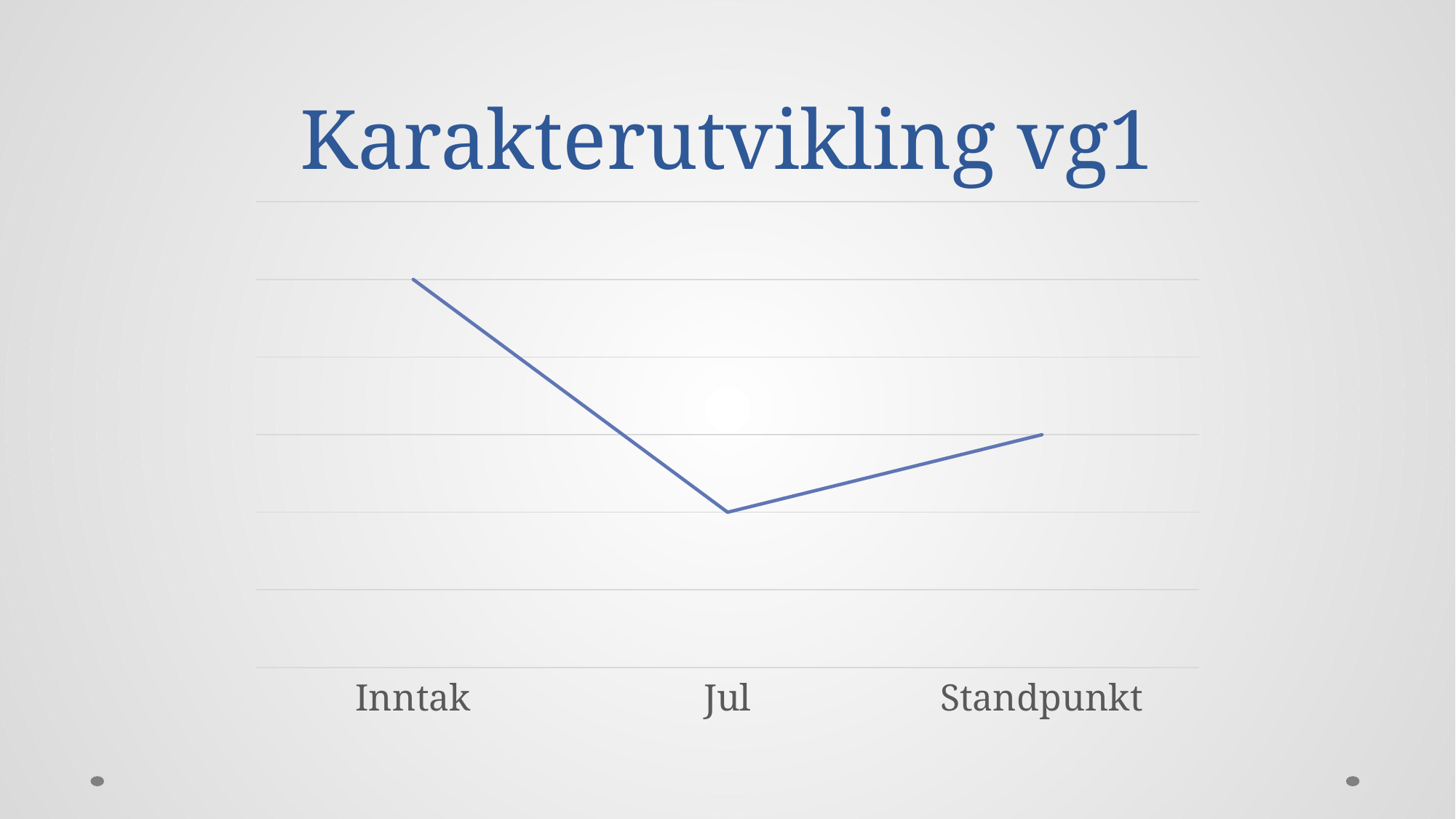
Which category has the lowest value? Jul Which is higher, the value for Jul or the value for Standpunkt? Standpunkt What is the title of the chart? Karakterutvikling vg1 What are the three category labels on the x axis, from left to right? Inntak, Jul, Standpunkt What kind of chart is shown on the slide? Line chart Which is higher, the value for Inntak or the value for Standpunkt? Inntak Does the value rise or fall from Inntak to Jul? Fall Does the value rise or fall from Jul to Standpunkt? Rise How many lines are plotted on the chart? 1 Which category has the highest value? Inntak How many categories are shown on the x axis? 3